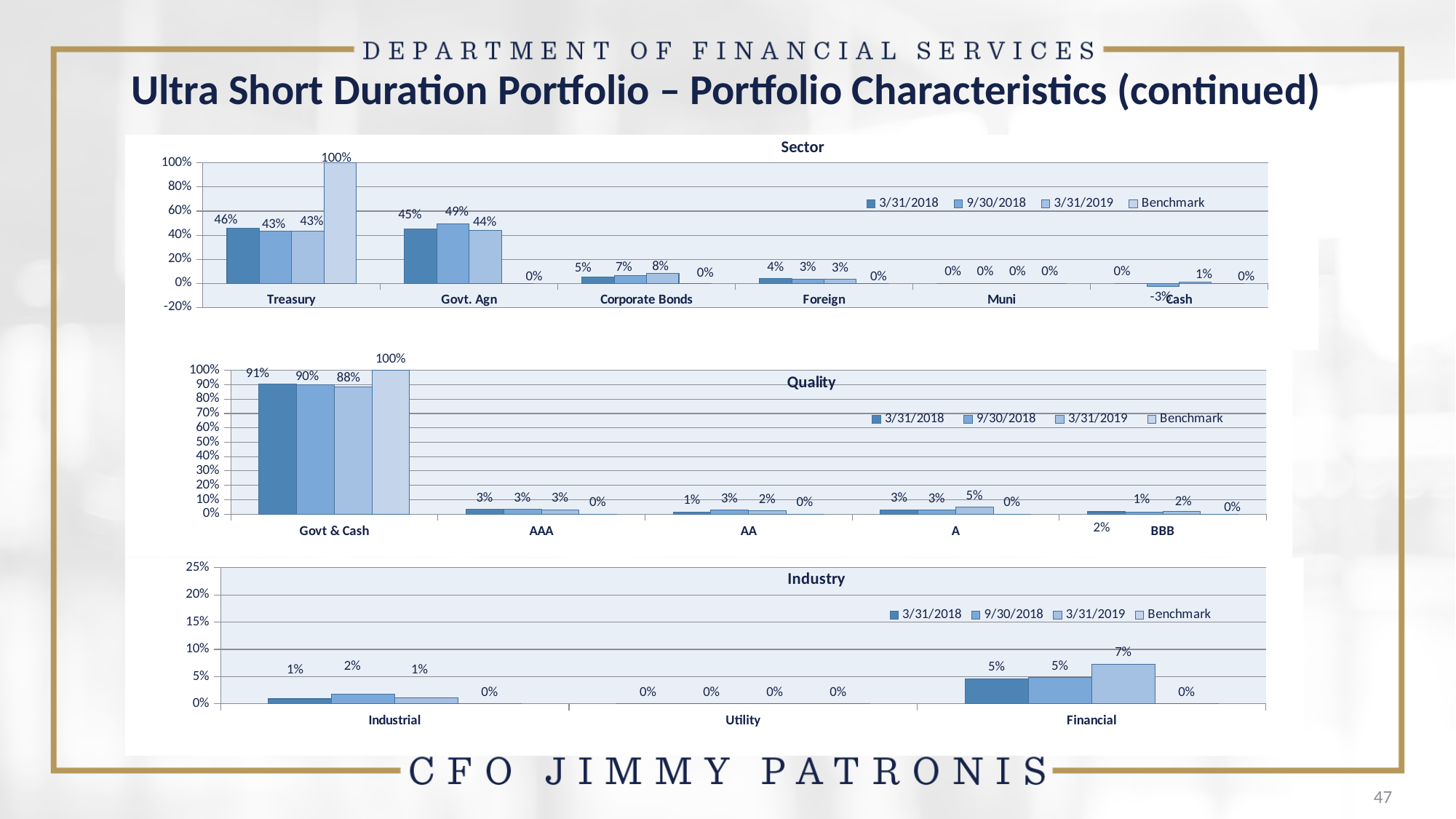
In the Industry chart, which is larger: the 9/30/2018 value for Industrial or the 9/30/2018 value for Financial? Financial In the Sector chart, how many series does the legend list? 4 In the Sector chart, what is the value for Treasury in the 3/31/2018 series? 46% In the Quality chart, which category has the highest 3/31/2018 value? Govt & Cash In the Sector chart, what is the value for Govt. Agn in the 9/30/2018 series? 49% In the Quality chart, what is the value for Govt & Cash in the 3/31/2019 series? 88% In the Quality chart, how many categories are shown on the x axis? 5 In the Industry chart, what is the value for Financial in the 3/31/2019 series? 7% In the Sector chart, what is the Benchmark value for Treasury? 100% What kind of chart is the Industry chart? Bar chart In the Quality chart, what is the value for A in the 3/31/2019 series? 5% In the Sector chart, what is the difference between the 3/31/2019 value for Corporate Bonds and the 3/31/2019 value for Foreign? 5%